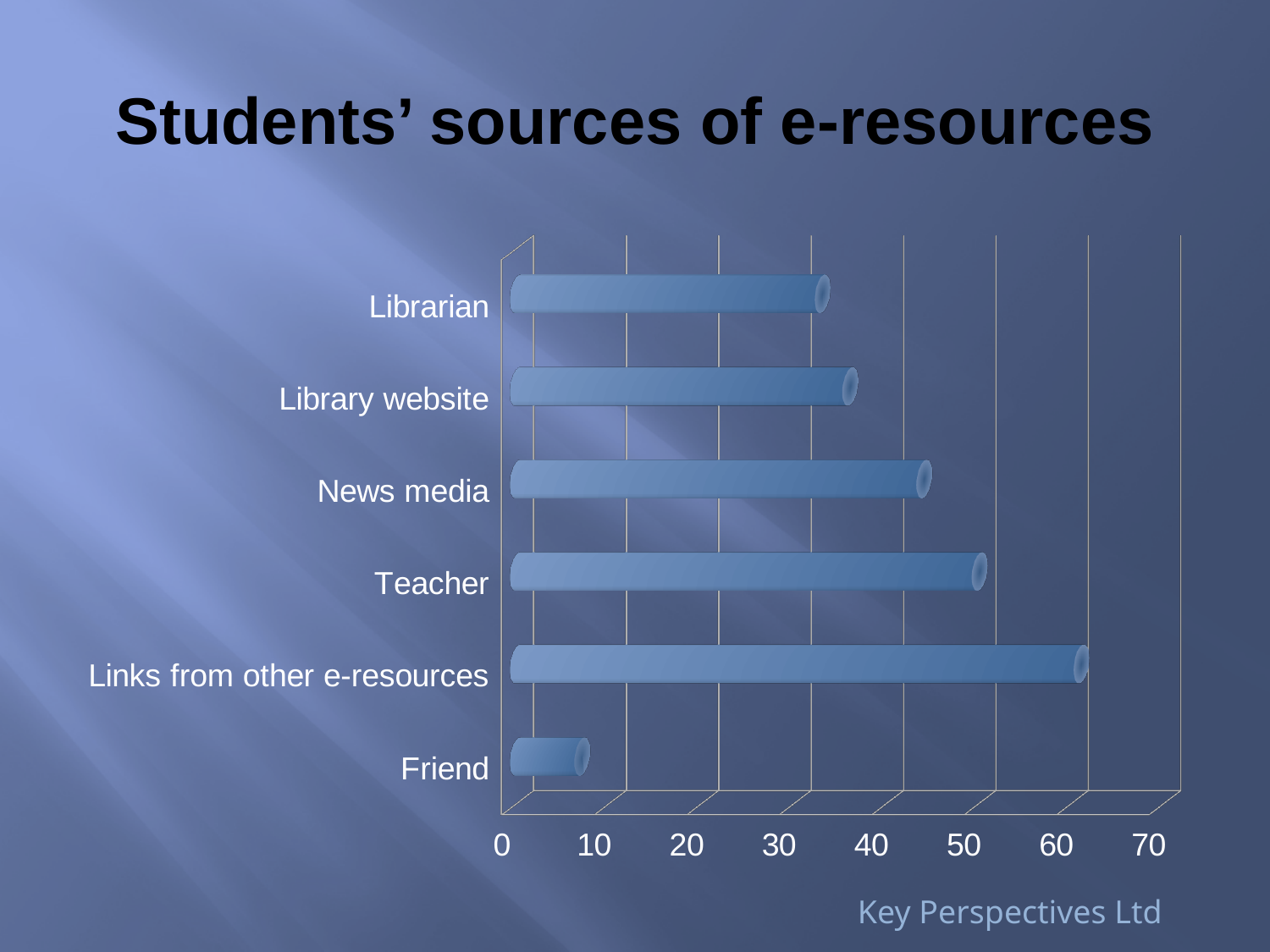
What kind of chart is shown on the slide? Bar chart Which is larger, the value for News media or the value for Library website? News media Is the value for News media greater or less than 50? less How many categories are plotted in the chart? 6 Which category has the highest value? Links from other e-resources Is the value for Links from other e-resources greater or less than 50? greater What is the title of the chart? Students' sources of e-resources Which category has the lowest value? Friend Is the value for Librarian greater or less than 40? less Which is larger, the value for Teacher or the value for Librarian? Teacher